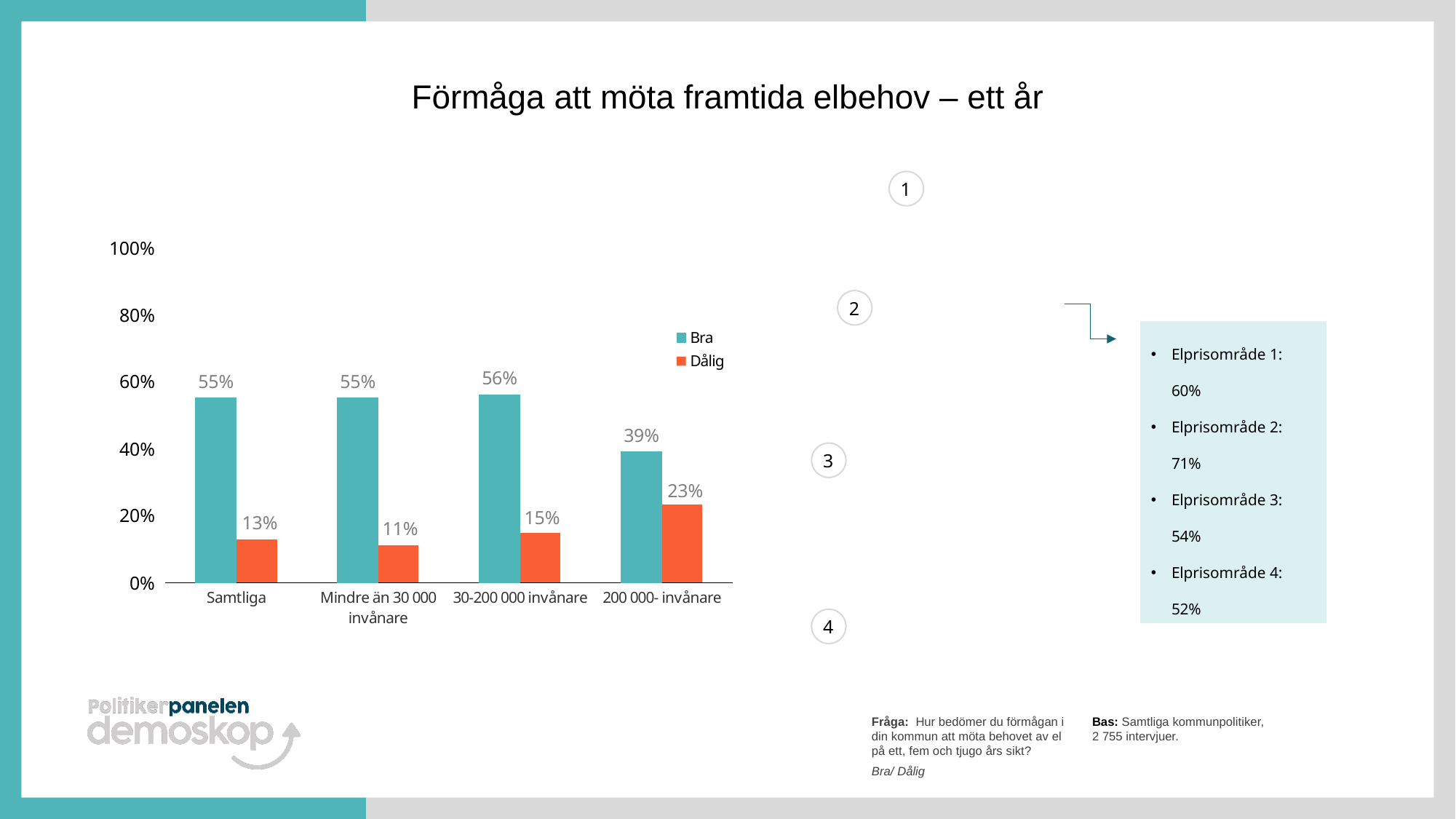
What kind of chart is shown on the slide? bar chart Is the Dålig value for 200 000- invånare larger or smaller than the Dålig value for Samtliga? larger Which category has the highest Bra value? 30-200 000 invånare What is the title of the slide? Förmåga att möta framtida elbehov – ett år What is the Dålig value for 200 000- invånare? 23% How many series does the legend list? 2 What is the difference between the Bra and Dålig values for 30-200 000 invånare? 41 percentage points Which category has the lowest Dålig value? Mindre än 30 000 invånare Which category has the lowest Bra value? 200 000- invånare What is the Dålig value for Mindre än 30 000 invånare? 11% What is the Bra value for Samtliga? 55% How many categories are shown on the x axis? 4